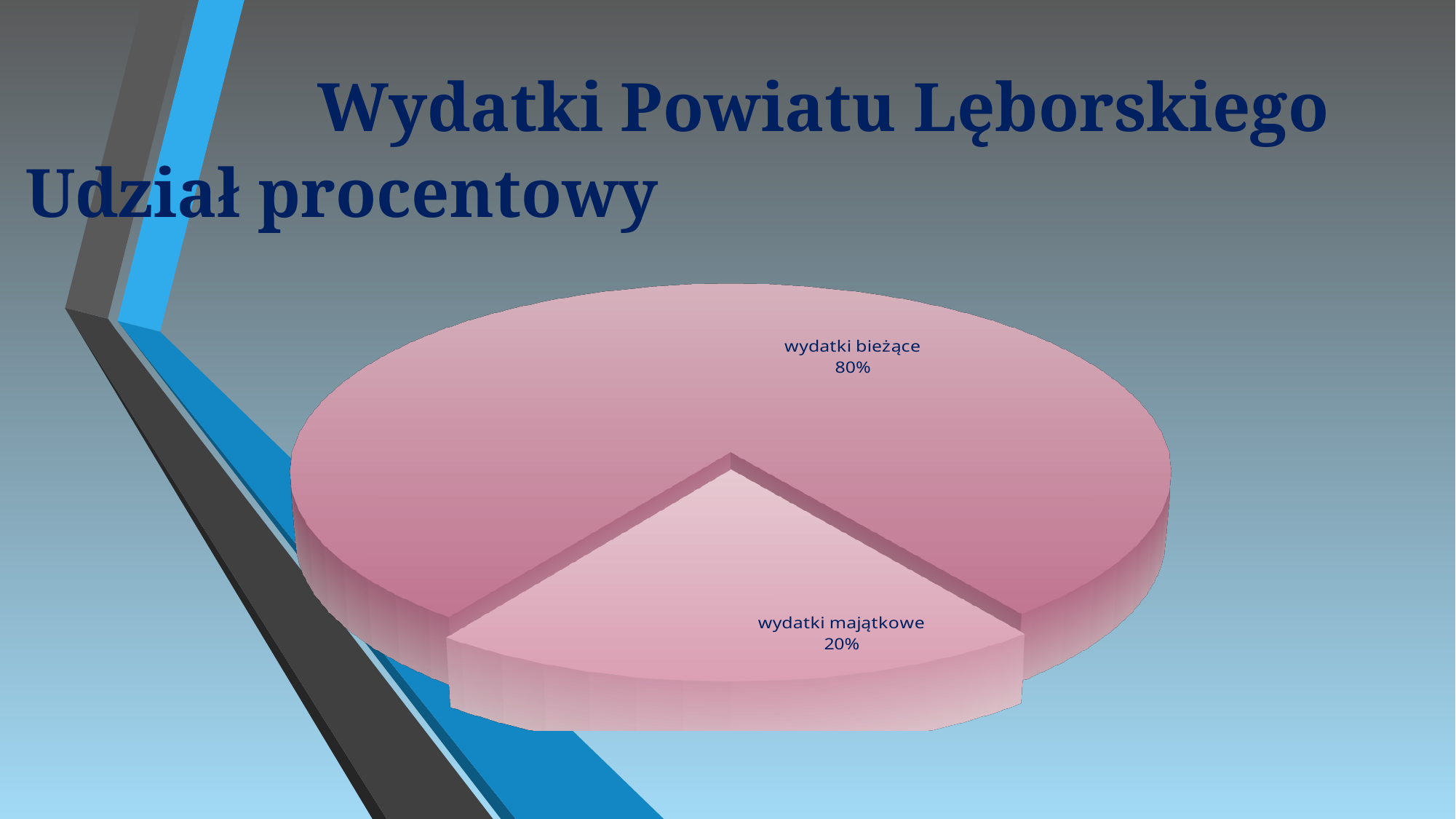
What is the title shown on the slide? Wydatki Powiatu Lęborskiego Udział procentowy Which is larger, "wydatki bieżące" or "wydatki majątkowe"? wydatki bieżące What share of the pie does "wydatki majątkowe" represent? 20% Which slice is pulled out (exploded) from the pie? wydatki majątkowe How many slices does the pie chart have? 2 What share of the pie does "wydatki bieżące" represent? 80% Which slice of the pie is the largest? wydatki bieżące What is the difference in percentage points between "wydatki bieżące" and "wydatki majątkowe"? 60 Which slice of the pie is the smallest? wydatki majątkowe What type of chart is shown on the slide? pie chart